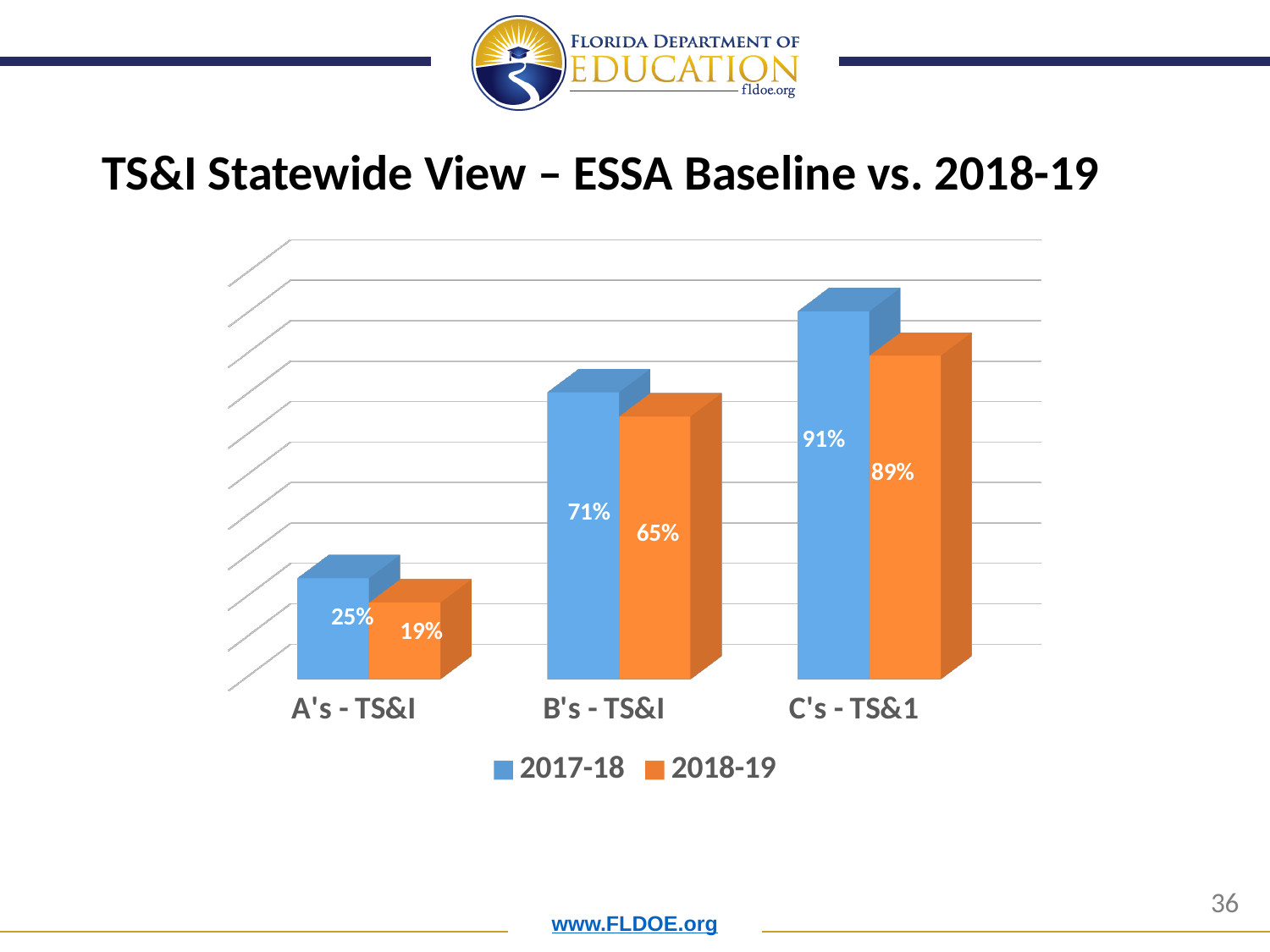
What is the difference between the 2017-18 and 2018-19 values for B's - TS&I? 6% What kind of chart is shown on the slide? Bar chart What is the 2017-18 value for C's - TS&1? 91% What is the 2018-19 value for B's - TS&I? 65% How many series does the legend list? 2 Which category has the lowest 2017-18 value? A's - TS&I What is the difference between the 2017-18 and 2018-19 values for C's - TS&1? 2% Which category has the highest 2018-19 value? C's - TS&1 Which is larger for A's - TS&I, the 2017-18 value or the 2018-19 value? 2017-18 What is the 2017-18 value for A's - TS&I? 25% How many categories are shown on the x axis? 3 What is the 2018-19 value for A's - TS&I? 19%